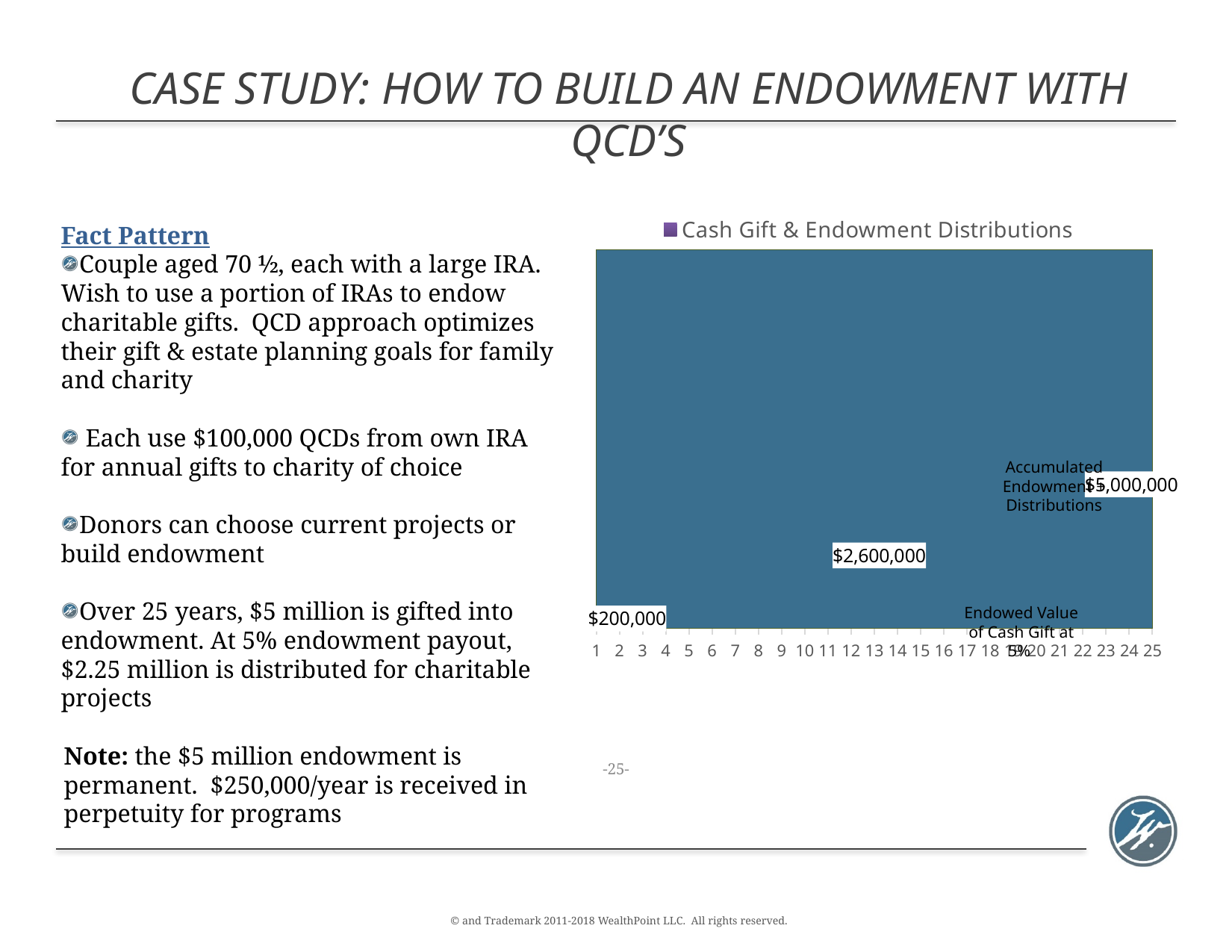
What is the middle data label shown on the chart? $2,600,000 Which category has the highest value in the chart? 25 How many categories are shown along the x axis of the chart? 25 Do the values rise or fall from category 1 to category 25? rise What value is labelled at category 25 of the chart? $5,000,000 Which category has the lowest value in the chart? 1 Which is larger, the value at category 25 or the value at category 1? category 25 What is the series name shown in the chart legend? Cash Gift & Endowment Distributions What kind of chart is shown on the slide? area chart What is the difference between the value labelled at category 25 and the value labelled at category 1? $4,800,000 How many series does the chart legend list? 1 What value is labelled at category 1 of the chart? $200,000